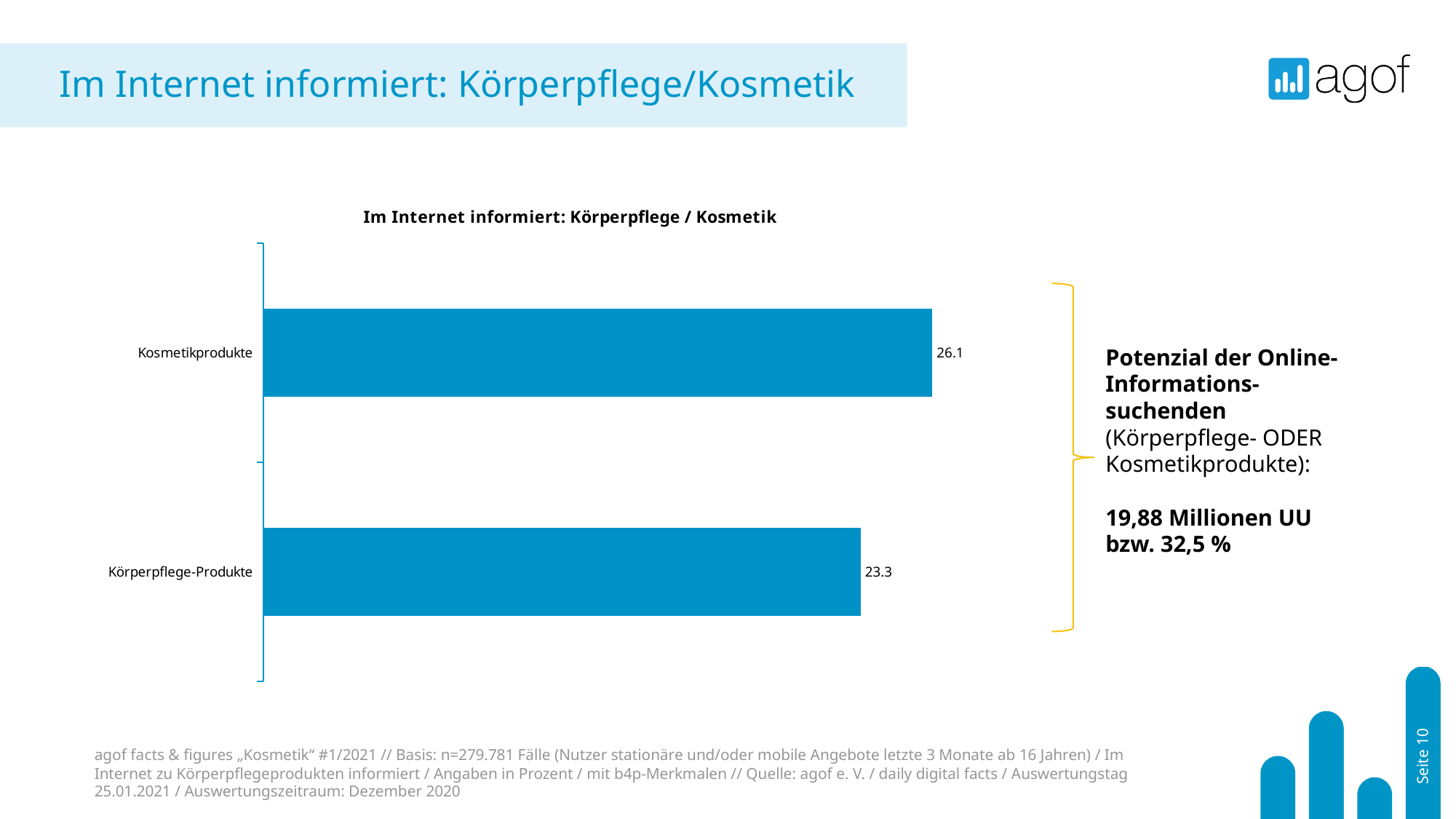
What is the value for Körperpflege-Produkte? 23.3 Which category has the lowest value? Körperpflege-Produkte How many categories are shown in the chart? 2 Which is larger, the value for Kosmetikprodukte or the value for Körperpflege-Produkte? Kosmetikprodukte What colour are the bars in the chart? Blue What kind of chart is shown on the slide? Bar chart What is the title of the chart? Im Internet informiert: Körperpflege / Kosmetik What is the difference between the values for Kosmetikprodukte and Körperpflege-Produkte? 2.8 What is the value for Kosmetikprodukte? 26.1 Which category has the highest value? Kosmetikprodukte